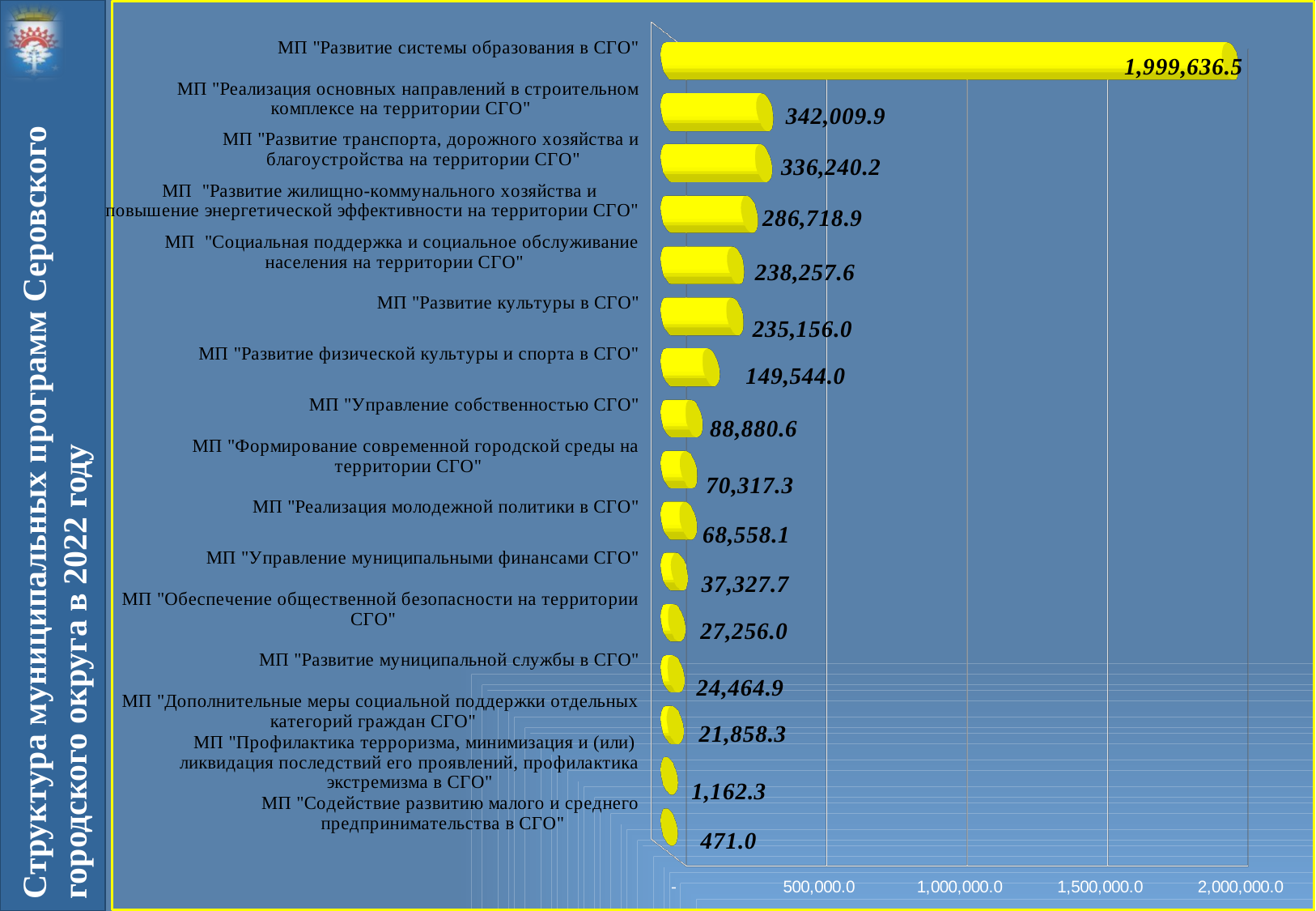
What is the title of the slide? Структура муниципальных программ Серовского городского округа в 2022 году How many programs (categories) are shown in the chart? 16 Which is larger: the value for МП "Управление собственностью СГО" or МП "Реализация молодежной политики в СГО"? МП "Управление собственностью СГО" Which program has the highest value? МП "Развитие системы образования в СГО" What is the value for МП "Управление муниципальными финансами СГО"? 37,327.7 What is the value for МП "Развитие культуры в СГО"? 235,156.0 What is the value for МП "Развитие системы образования в СГО"? 1,999,636.5 Is the value for МП "Развитие системы образования в СГО" greater or less than 1,500,000.0? greater What is the difference between the values for МП "Реализация основных направлений в строительном комплексе на территории СГО" and МП "Развитие транспорта, дорожного хозяйства и благоустройства на территории СГО"? 5,769.7 What kind of chart is shown on the slide? Bar chart Which program has the lowest value? МП "Содействие развитию малого и среднего предпринимательства в СГО" What is the difference between the values for МП "Социальная поддержка и социальное обслуживание населения на территории СГО" and МП "Развитие культуры в СГО"? 3,101.6